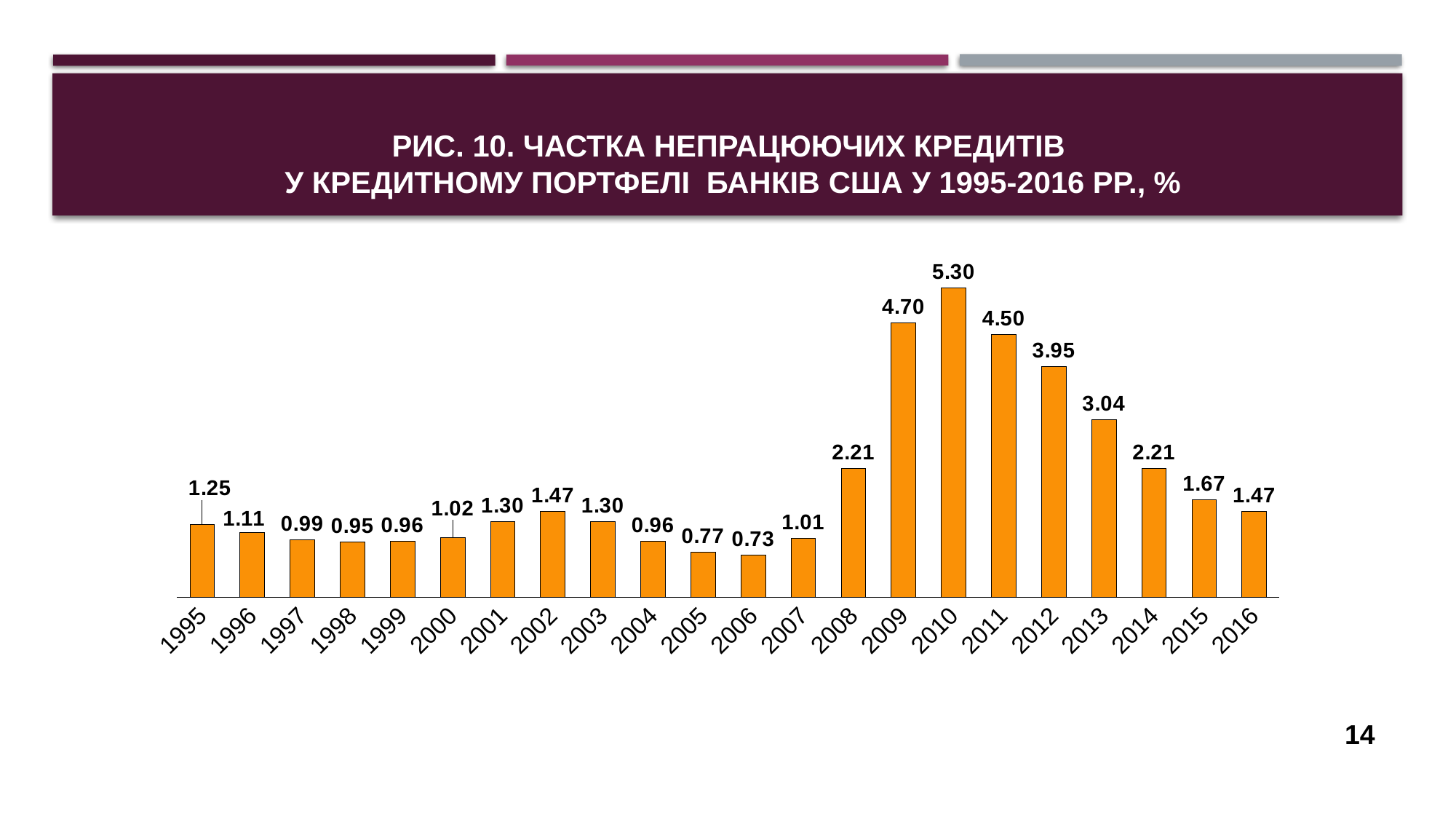
What is the difference between the values for 2010 and 2009? 0.60 What is the value for 2006? 0.73 What is the difference between the values for 2012 and 2013? 0.91 What kind of chart is this? bar chart Which year has the highest value? 2010 What is the value for 2016? 1.47 Which is larger, the value for 2008 or the value for 2013? 2013 Do the values rise or fall from 2010 to 2016? fall Which is larger, the value for 1995 or the value for 2002? 2002 Which year has the lowest value? 2006 How many years are shown on the x axis? 22 What is the value for 2010? 5.30